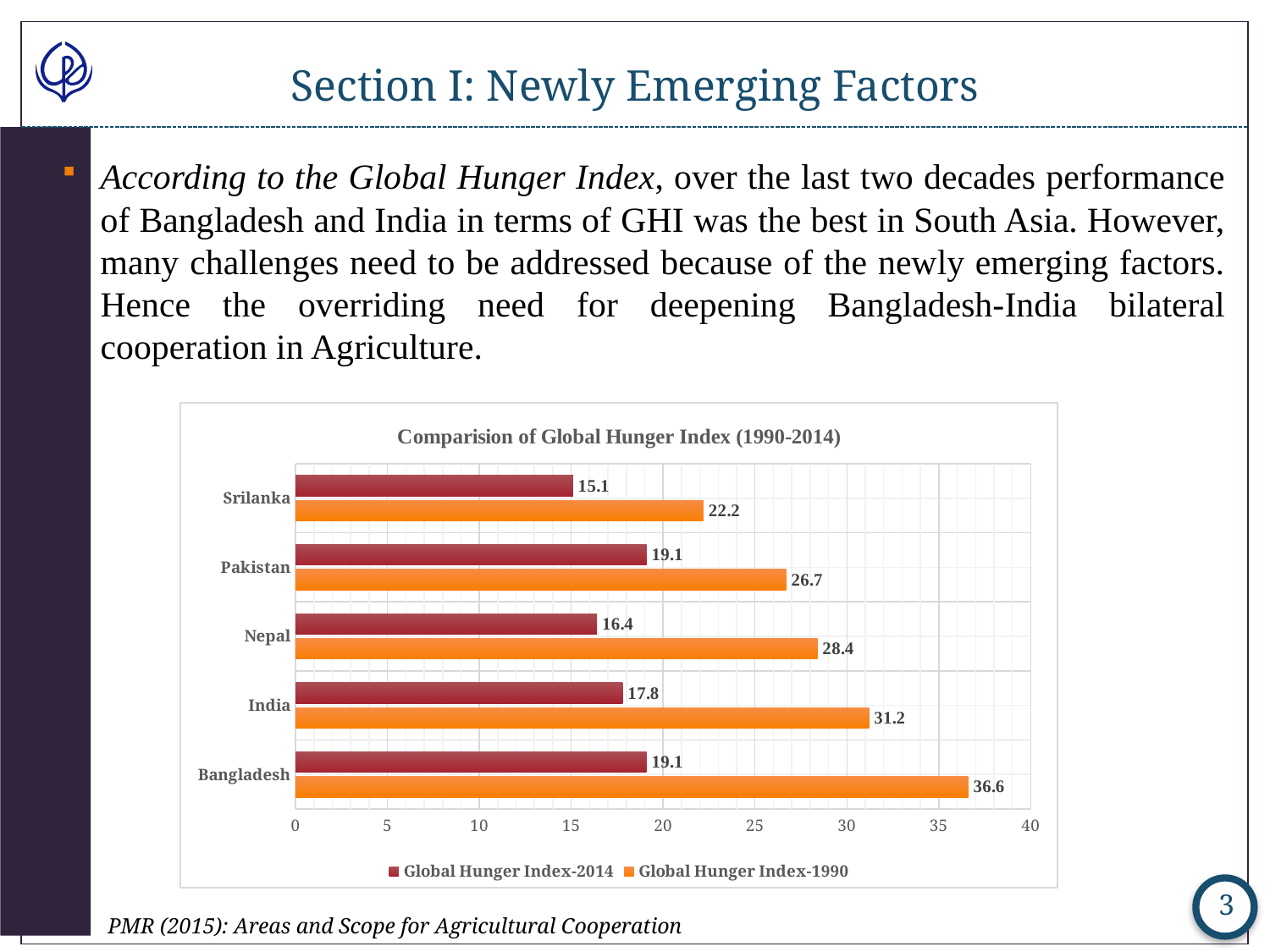
What is the Global Hunger Index-2014 value for Srilanka? 15.1 What is the Global Hunger Index-1990 value for Nepal? 28.4 Which country has the highest Global Hunger Index-1990 value? Bangladesh Which is larger: the Global Hunger Index-1990 value for Pakistan or for Nepal? Nepal How many series does the legend list? 2 Is the Global Hunger Index-1990 value for Srilanka greater or less than 20? greater What kind of chart is shown on the slide? Bar chart What is the difference between the Global Hunger Index-1990 and Global Hunger Index-2014 values for India? 13.4 What is the title of the chart? Comparision of Global Hunger Index (1990-2014) How many countries are shown in the chart? 5 Which country has the lowest Global Hunger Index-2014 value? Srilanka What is the Global Hunger Index-1990 value for Bangladesh? 36.6